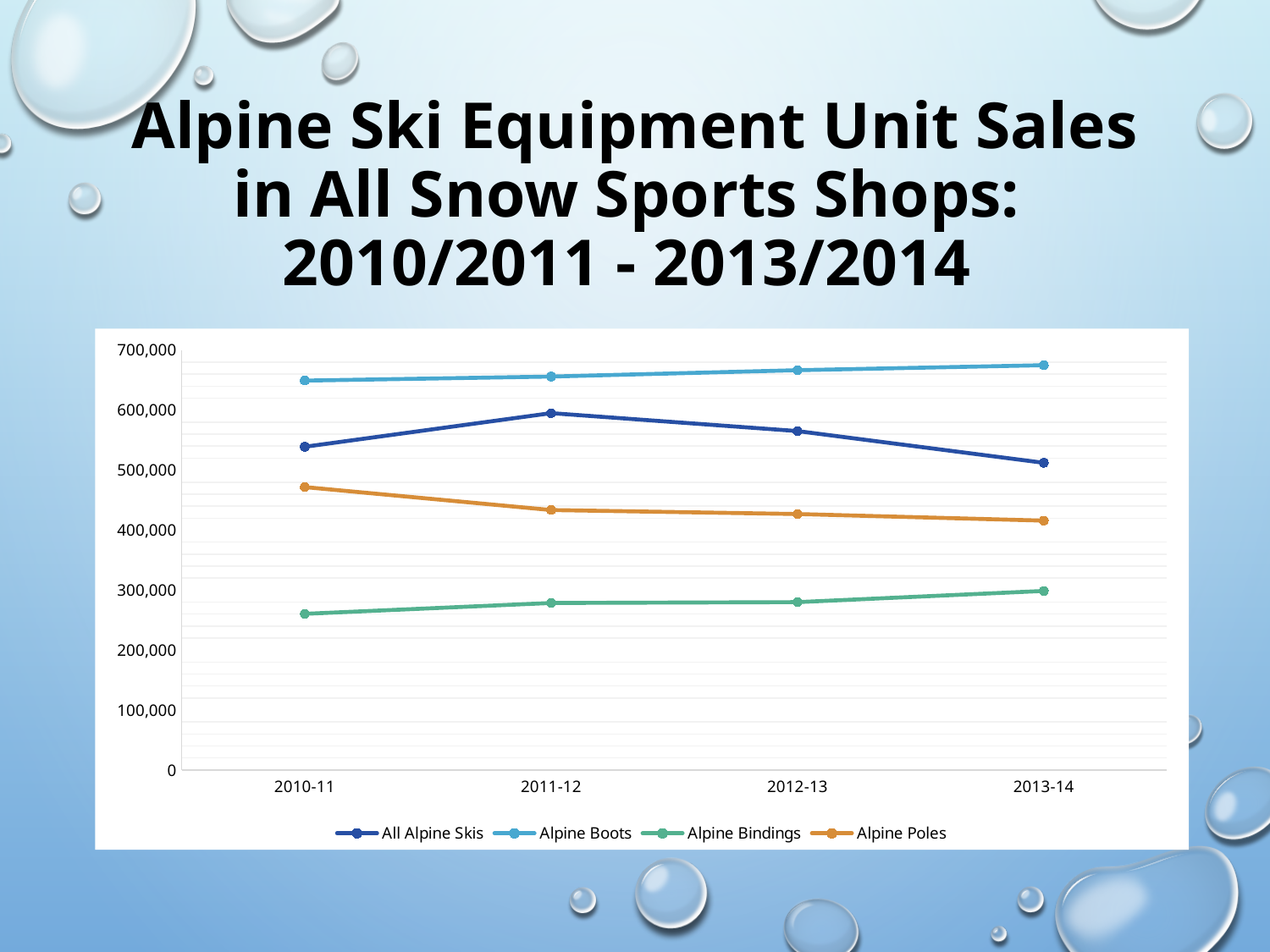
How many seasons are plotted along the x axis? 4 Is the value for All Alpine Skis in 2011-12 greater or less than 500,000? greater How many series does the legend list? 4 Which series has the lowest value in 2010-11? Alpine Bindings Is the value for Alpine Poles in 2013-14 greater or less than 400,000? greater What kind of chart is shown on the slide? line chart In 2012-13, which is larger: All Alpine Skis or Alpine Poles? All Alpine Skis Do the values for Alpine Poles rise or fall from 2010-11 to 2013-14? fall Which series has the highest value in 2013-14? Alpine Boots Is the value for Alpine Bindings in 2010-11 greater or less than 300,000? less In which season does All Alpine Skis reach its highest value? 2011-12 Do the values for Alpine Boots rise or fall from 2010-11 to 2013-14? rise